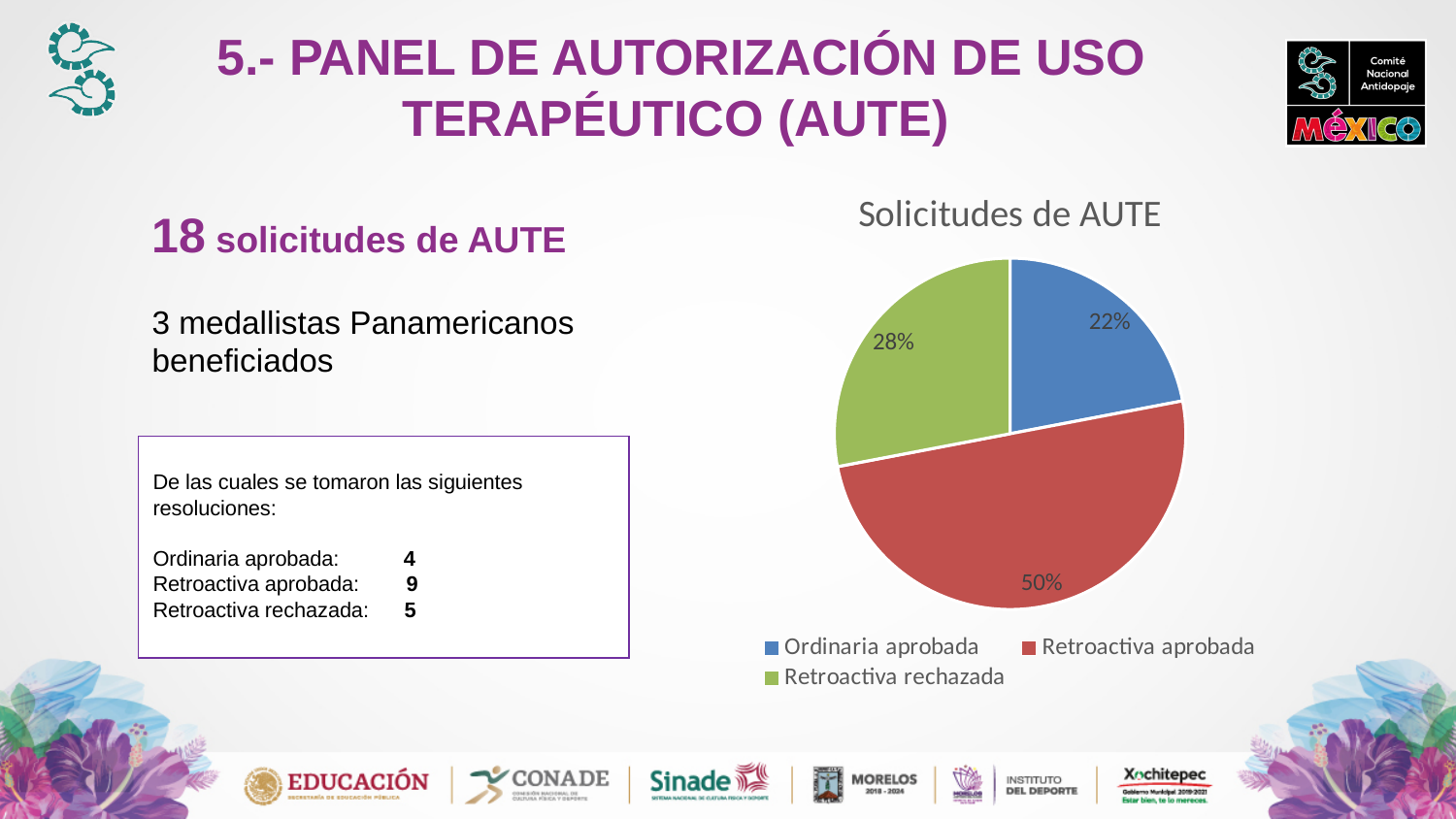
What is the difference in percentage points between Retroactiva aprobada and Ordinaria aprobada? 28 What is the title of the chart? Solicitudes de AUTE Which category has the smallest slice of the pie? Ordinaria aprobada What type of chart is shown on the slide? pie chart Which category has the largest slice of the pie? Retroactiva aprobada What percentage of the pie does Ordinaria aprobada represent? 22% What percentage of the pie does Retroactiva rechazada represent? 28% What percentage of the pie does Retroactiva aprobada represent? 50% What colour is the slice for Retroactiva aprobada? red How many slices does the pie chart have? 3 How many entries does the legend list? 3 Which is larger, the share for Retroactiva rechazada or the share for Ordinaria aprobada? Retroactiva rechazada